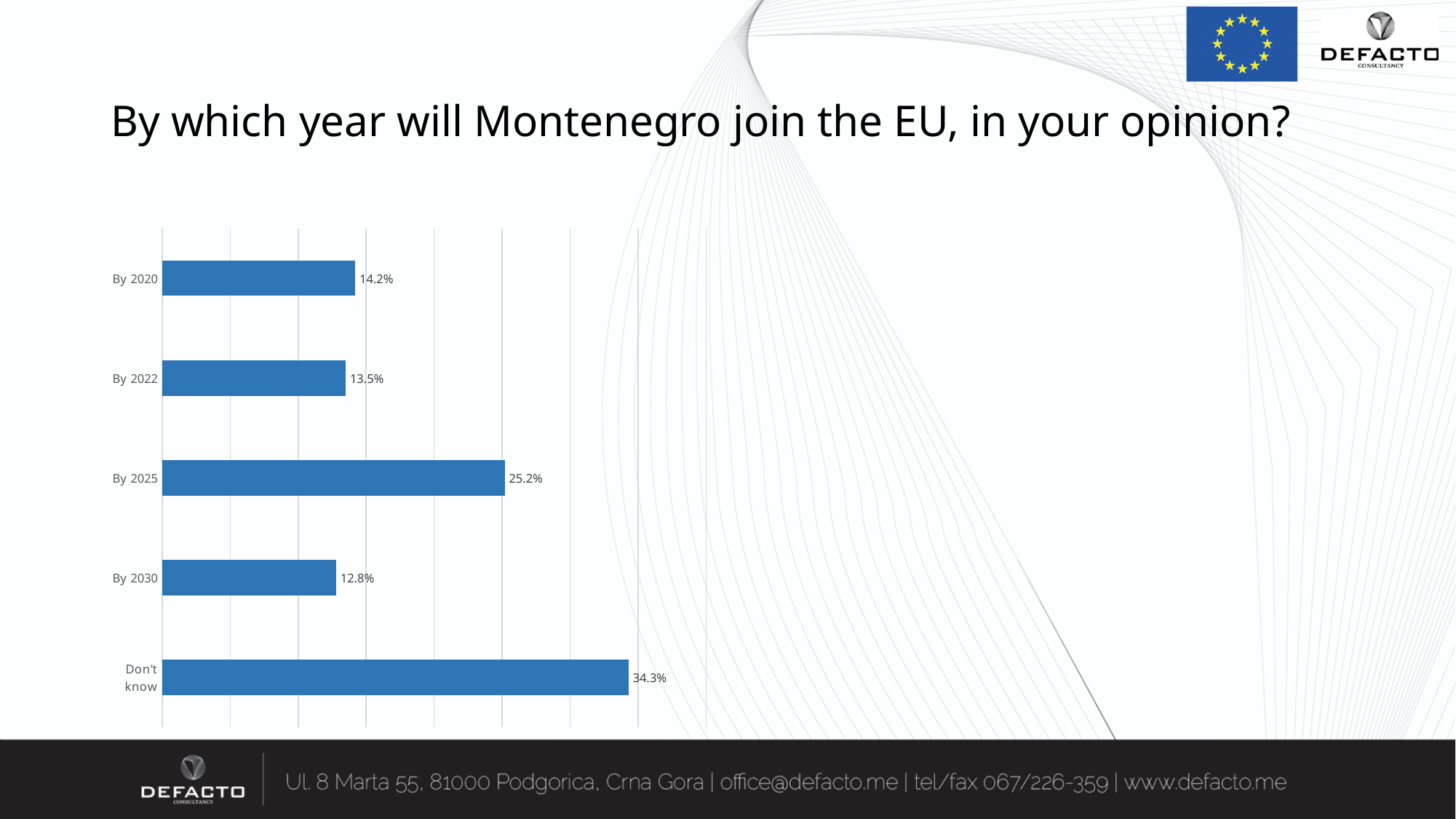
How many categories are shown in the chart? 5 Which category has the lowest value? By 2030 Which is larger: the value for 'By 2025' or the value for 'By 2022'? By 2025 What is the value for the 'Don't know' category? 34.3% What question does the slide title pose? By which year will Montenegro join the EU, in your opinion? What is the value shown for 'By 2030'? 12.8% Which category has the highest value? Don't know What is the difference between the 'Don't know' value and the 'By 2025' value? 9.1% What percentage of respondents think Montenegro will join the EU by 2025? 25.2% What is the difference between the 'By 2020' and 'By 2022' values? 0.7% What type of chart is shown on the slide? Bar chart What percentage of respondents chose 'By 2020'? 14.2%